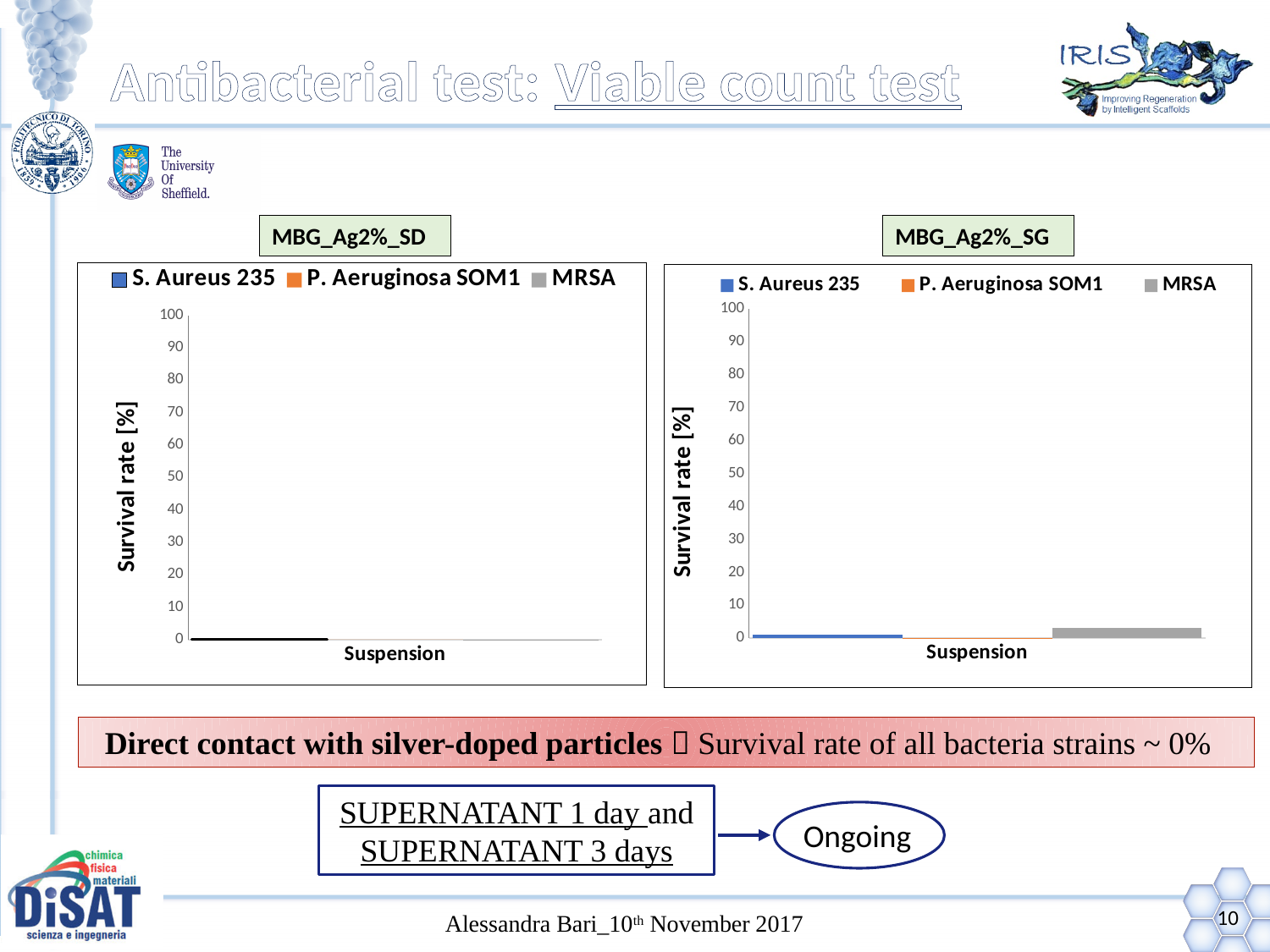
What is the y-axis title of the MBG_Ag2%_SD chart? Survival rate [%] How many series does the legend of the MBG_Ag2%_SG chart list? 3 How many series does the legend of the MBG_Ag2%_SD chart list? 3 What kind of chart is the MBG_Ag2%_SG chart on the right? Bar chart How many categories are shown on the x axis of the MBG_Ag2%_SD chart? 1 In the MBG_Ag2%_SG chart, is the value for P. Aeruginosa SOM1 greater or less than 20? less In the MBG_Ag2%_SG chart, is the value for MRSA greater or less than 10? less What is the category label on the x axis of the MBG_Ag2%_SG chart? Suspension What kind of chart is the MBG_Ag2%_SD chart on the left? Bar chart In the MBG_Ag2%_SD chart, is the value for S. Aureus 235 greater or less than 10? less